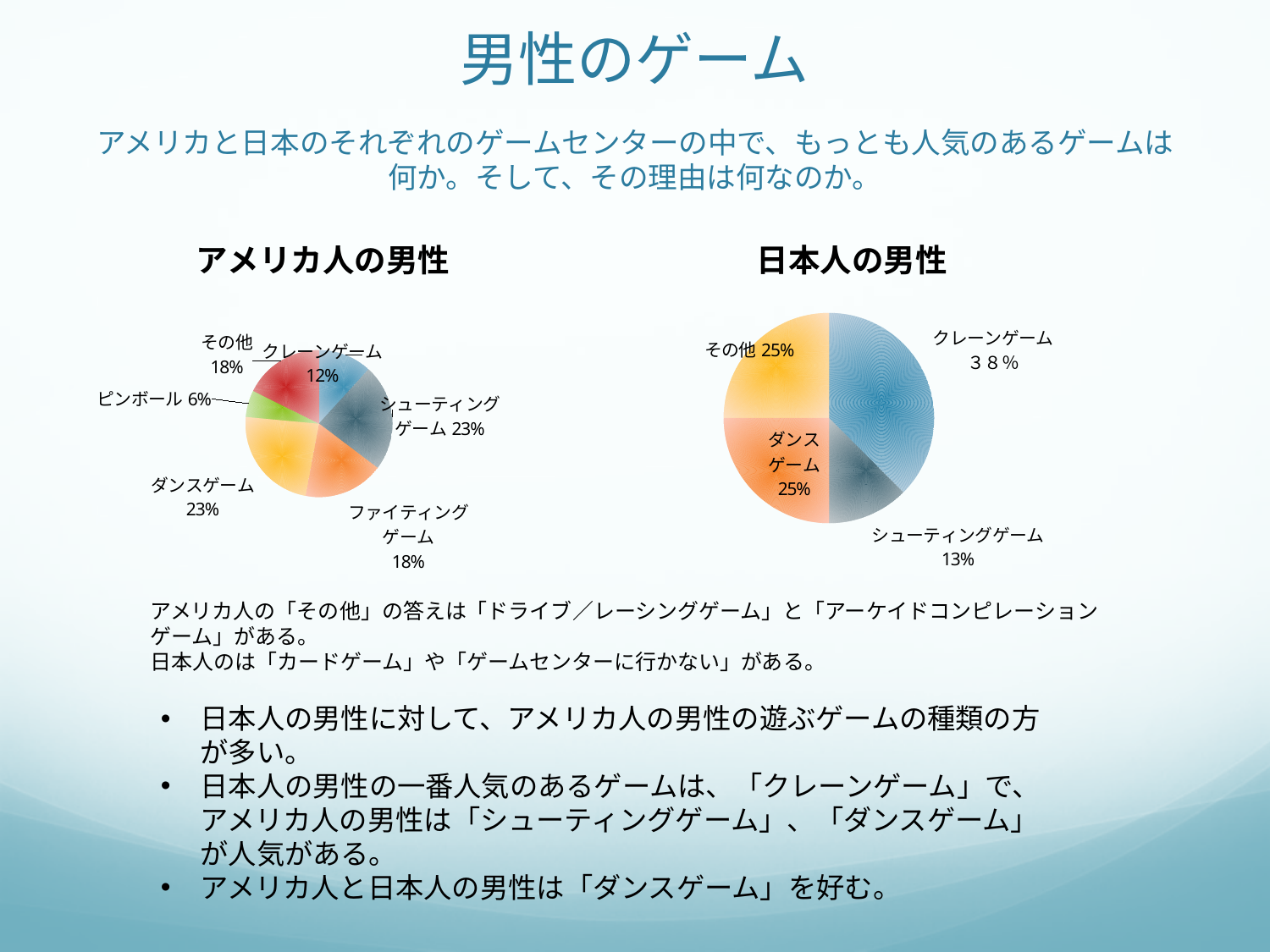
How many categories are shown in the アメリカ人の男性 chart? 6 In the アメリカ人の男性 chart, what percentage is shown for ピンボール? 6% In the アメリカ人の男性 chart, what percentage is shown for クレーンゲーム? 12% In the 日本人の男性 chart, what percentage is shown for シューティングゲーム? 13% In the 日本人の男性 chart, which category has the largest slice? クレーンゲーム What type of chart is used for 日本人の男性? Pie chart In the アメリカ人の男性 chart, what is the difference between the シューティングゲーム and クレーンゲーム percentages? 11% In the 日本人の男性 chart, which category has the smallest slice? シューティングゲーム In the アメリカ人の男性 chart, which category has the smallest slice? ピンボール How many categories are shown in the 日本人の男性 chart? 4 In the 日本人の男性 chart, which is larger, その他 or シューティングゲーム? その他 In the 日本人の男性 chart, what percentage is shown for クレーンゲーム? ３８％